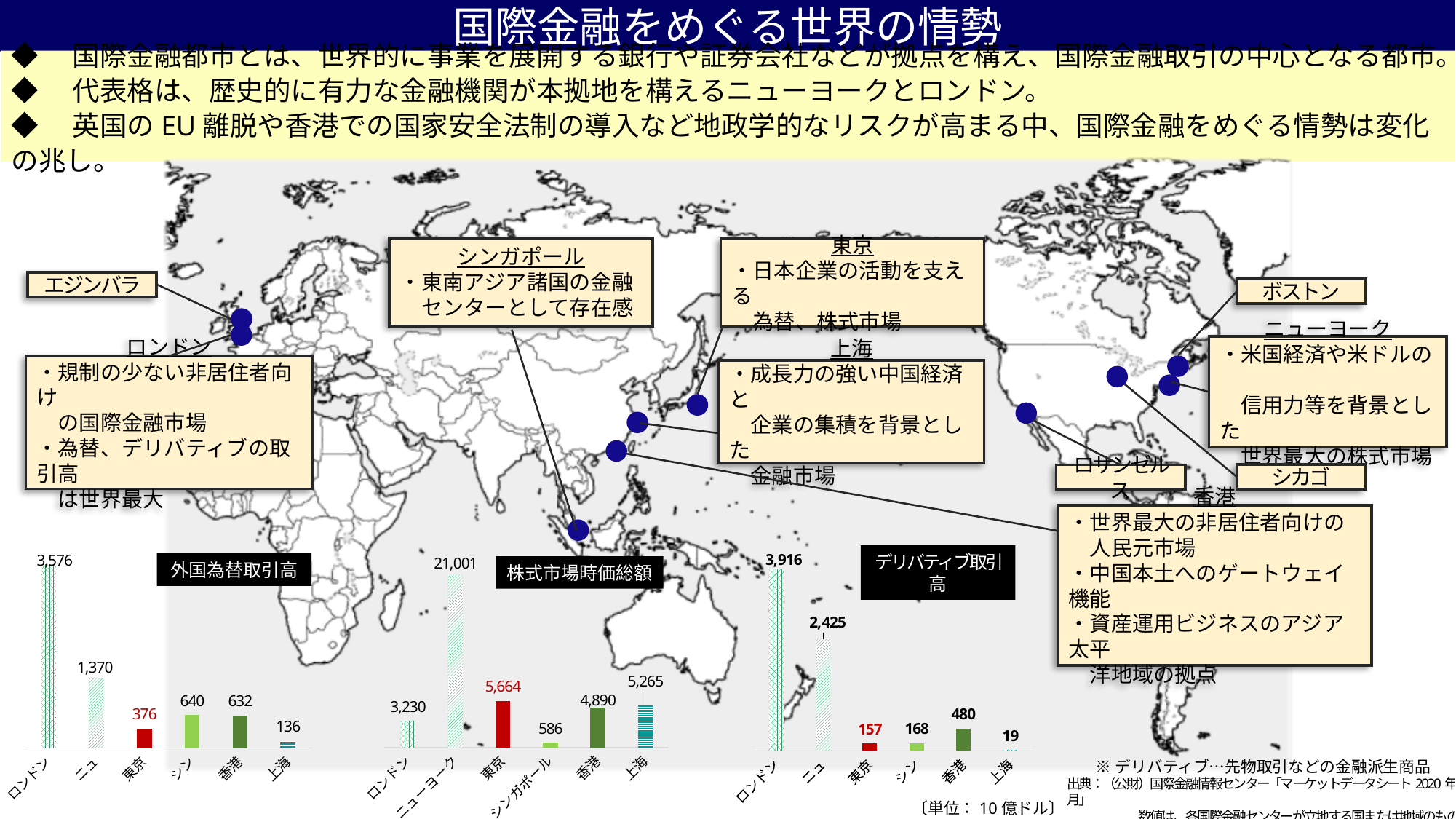
「株式市場時価総額」のグラフで、香港の値はいくらですか？ 4,890 「デリバティブ取引高」のグラフで、最も値が大きい都市はどこですか？ ロンドン 「デリバティブ取引高」のグラフはどの種類のグラフですか？ 棒グラフ 「株式市場時価総額」のグラフで、シンガポールの値はいくらですか？ 586 「デリバティブ取引高」のグラフで、ロンドンとニューヨークの値の差はいくらですか？ 1,491 「外国為替取引高」のグラフで、最も値が小さい都市はどこですか？ 上海 「外国為替取引高」のグラフで、ニューヨークと東京の値の差はいくらですか？ 994 「株式市場時価総額」のグラフで、東京と上海ではどちらの値が大きいですか？ 東京 「外国為替取引高」のグラフには、いくつの都市が示されていますか？ 6 「外国為替取引高」のグラフで、ロンドンの値はいくらですか？ 3,576 「デリバティブ取引高」のグラフで、香港の値はいくらですか？ 480 「株式市場時価総額」のグラフで、最も値が大きい都市はどこですか？ ニューヨーク